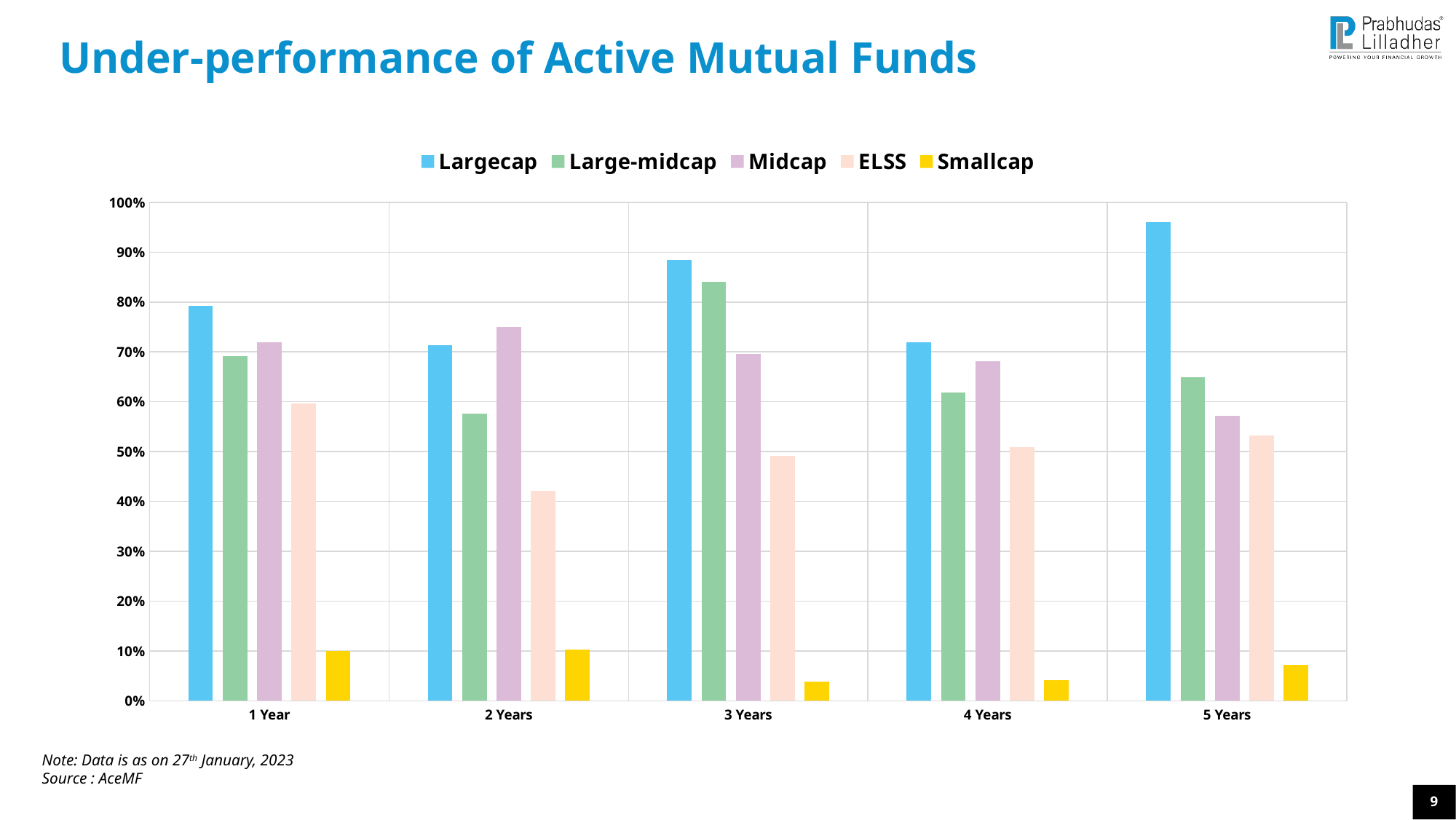
Which series has the lowest value in the 3 Years category? Smallcap In which category does Largecap reach its highest value? 5 Years Is the value for Largecap at 5 Years greater or less than 90%? greater Which series has the highest value in the 5 Years category? Largecap What kind of chart is shown on the slide? Bar chart In the 2 Years category, which is larger: Midcap or Largecap? Midcap How many time-period categories are shown on the x axis? 5 In the 1 Year category, which is larger: Large-midcap or ELSS? Large-midcap Is the value for ELSS at 2 Years greater or less than 50%? less Is the value for Smallcap at 3 Years greater or less than 10%? less What is the title of the slide? Under-performance of Active Mutual Funds How many series does the legend list? 5